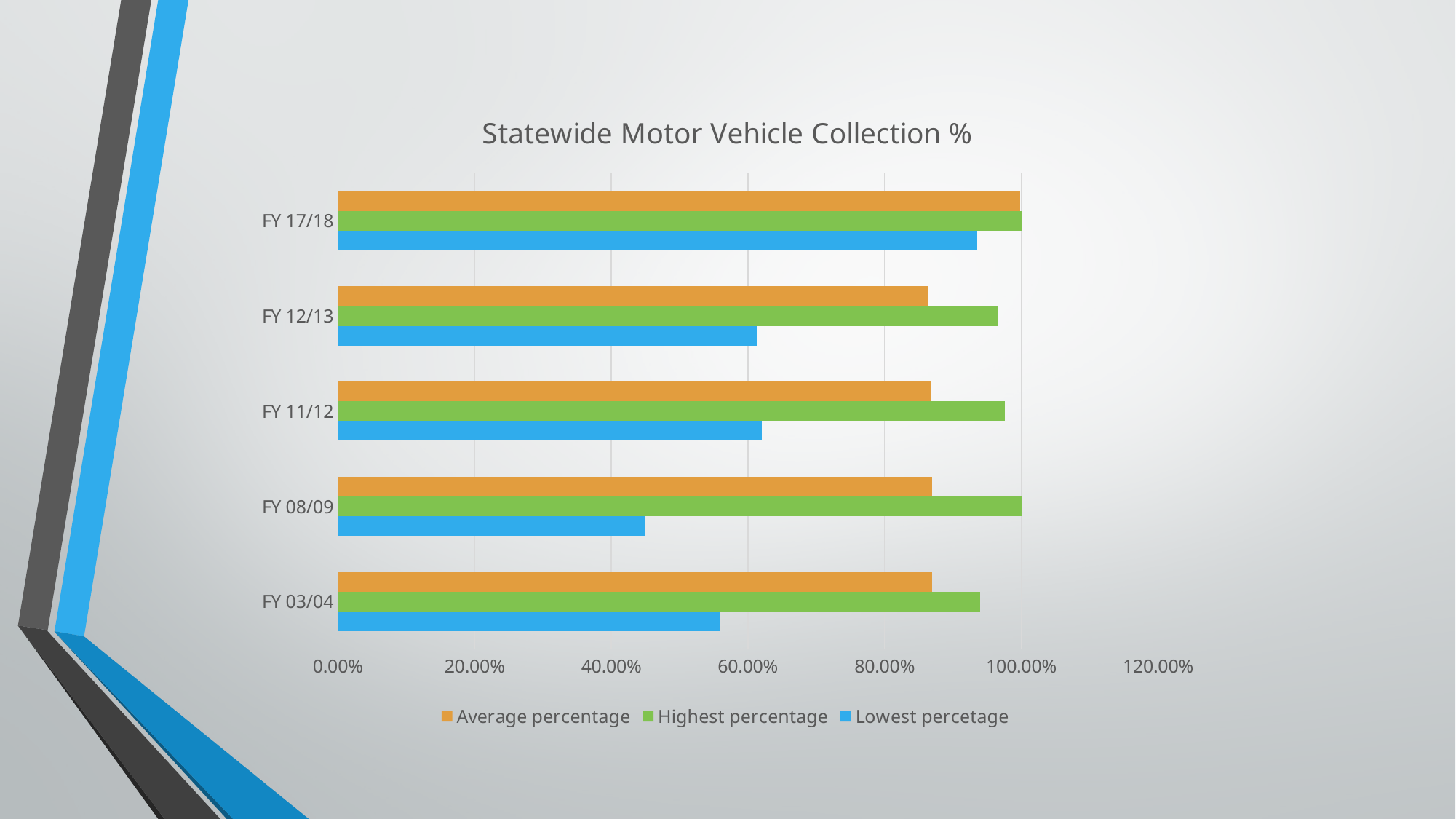
Is the Lowest percetage value for FY 17/18 greater or less than 80.00%? greater Which fiscal year has the highest value for the Lowest percetage series? FY 17/18 How many series does the legend list? 3 What type of chart is shown on the slide? Bar chart Is the Lowest percetage value for FY 03/04 greater or less than 60.00%? less Is the Average percentage value for FY 12/13 greater or less than 80.00%? greater Which fiscal year has the lowest value for the Lowest percetage series? FY 08/09 How many fiscal years are shown on the chart? 5 What is the title of the chart? Statewide Motor Vehicle Collection % Which is larger: the Lowest percetage for FY 03/04 or the Lowest percetage for FY 08/09? FY 03/04 Which colour represents the Highest percentage series? Green